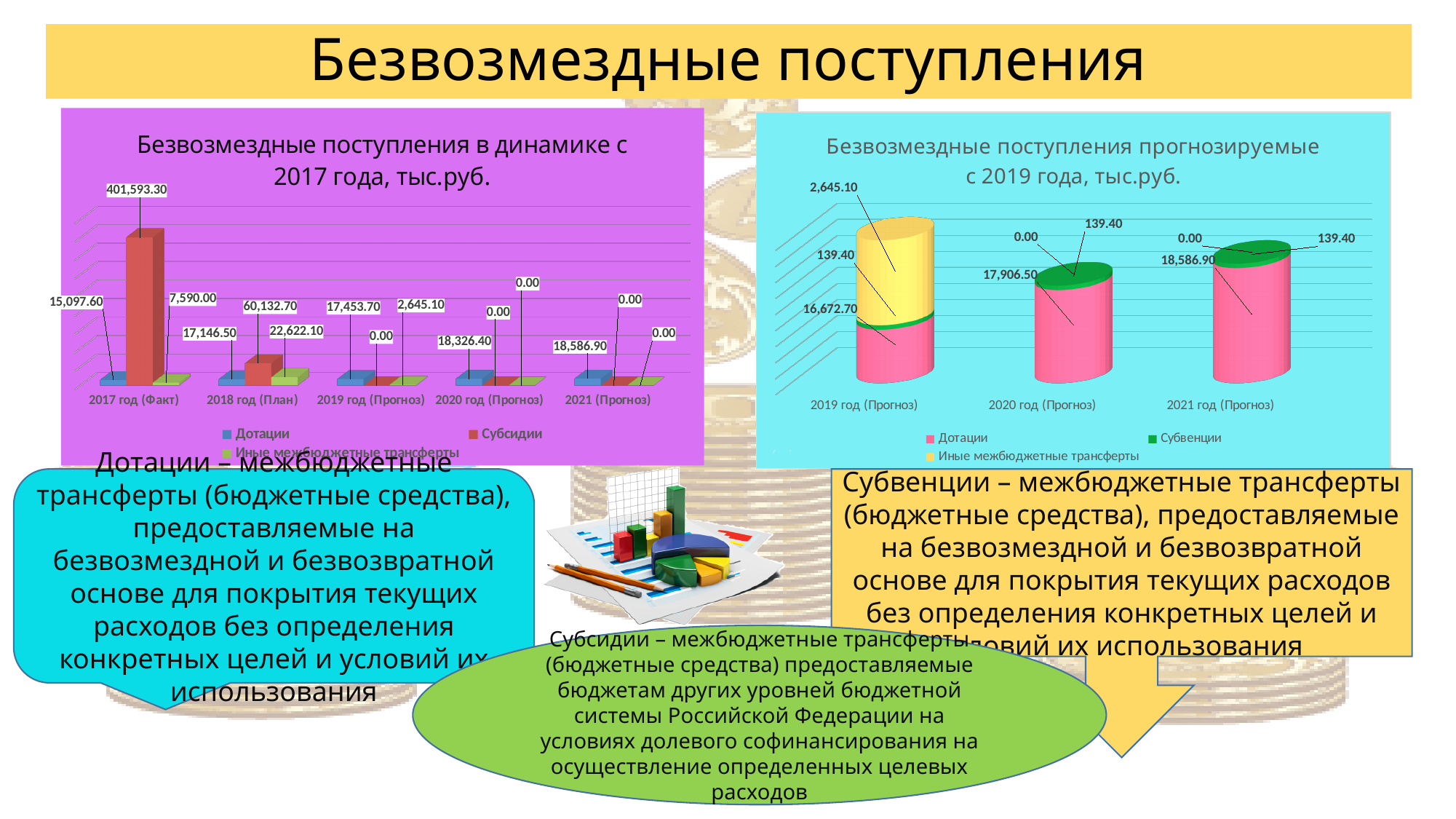
In the chart 'Безвозмездные поступления в динамике с 2017 года', which category has the highest Субсидии value? 2017 год (Факт) In the chart 'Безвозмездные поступления прогнозируемые с 2019 года', how many series does the legend list? 3 In the chart 'Безвозмездные поступления прогнозируемые с 2019 года', what is the value of Иные межбюджетные трансферты for 2019 год (Прогноз)? 2,645.10 In the chart 'Безвозмездные поступления в динамике с 2017 года', how many categories are shown on the x axis? 5 In the chart 'Безвозмездные поступления в динамике с 2017 года', what is the difference between the Субсидии values for 2017 год (Факт) and 2018 год (План)? 341,460.60 In the chart 'Безвозмездные поступления прогнозируемые с 2019 года', which series is shown in green? Субвенции In the chart 'Безвозмездные поступления прогнозируемые с 2019 года', what is the value of Дотации for 2020 год (Прогноз)? 17,906.50 In the chart 'Безвозмездные поступления в динамике с 2017 года', what is the value of Иные межбюджетные трансферты for 2018 год (План)? 22,622.10 In the chart 'Безвозмездные поступления в динамике с 2017 года', what is the value of Субсидии for 2017 год (Факт)? 401,593.30 In the chart 'Безвозмездные поступления в динамике с 2017 года', what is the value of Дотации for 2018 год (План)? 17,146.50 In the chart 'Безвозмездные поступления в динамике с 2017 года', do the Дотации values rise or fall from 2017 to 2021? rise In the chart 'Безвозмездные поступления прогнозируемые с 2019 года', what is the total of the stacked bar for 2021 год (Прогноз)? 18,726.30